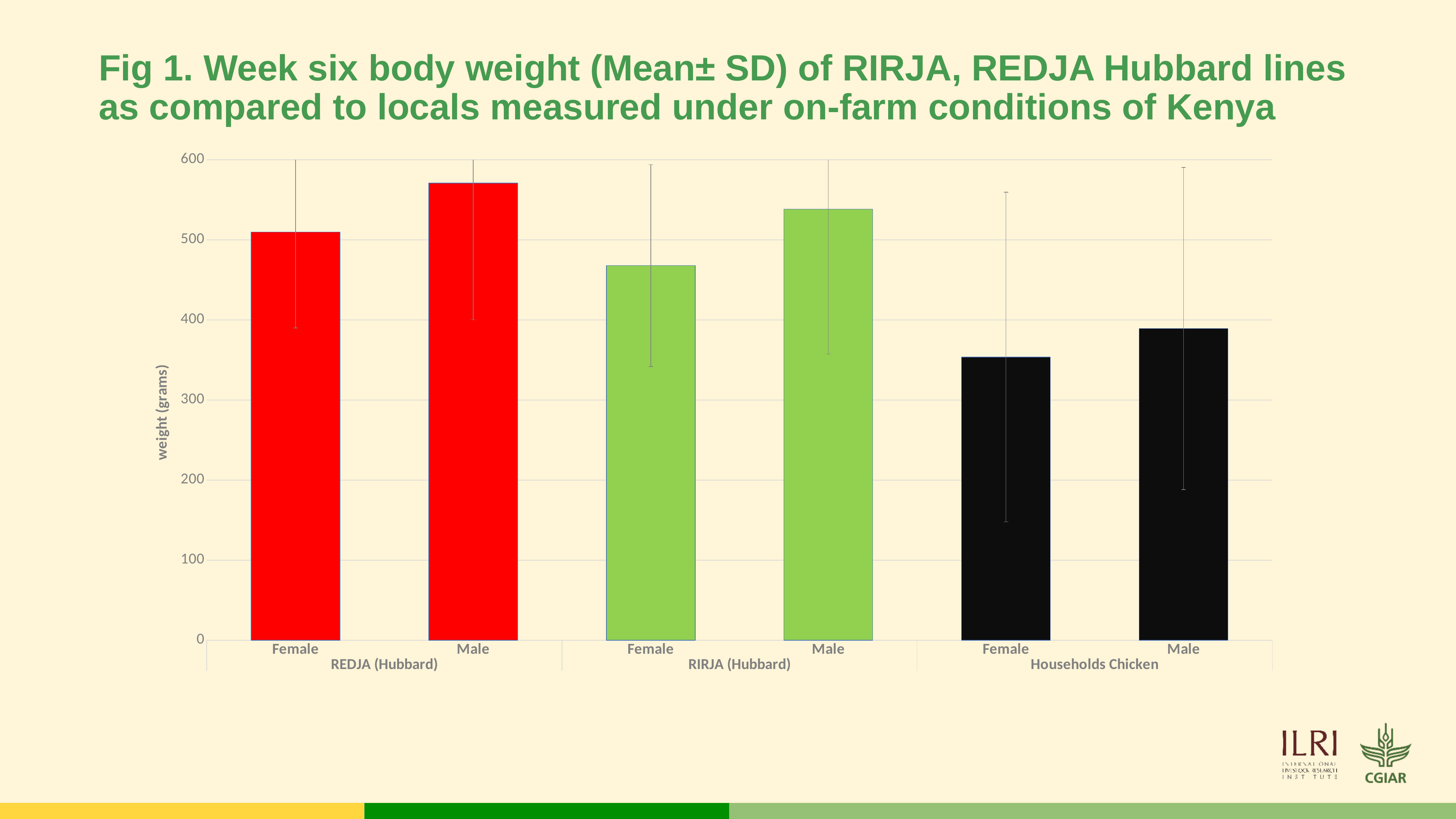
How many bars are plotted in the chart? 6 Which bar is the lowest in the chart? Households Chicken Female What kind of chart is shown on the slide? bar chart How many chicken groups are shown along the x axis? 3 Is the value for REDJA (Hubbard) Female greater or less than 500? greater Which bar is the highest in the chart? REDJA (Hubbard) Male Which is larger, the value for Households Chicken Female or Households Chicken Male? Households Chicken Male Is the value for Households Chicken Male greater or less than 400? less Is the value for RIRJA (Hubbard) Female greater or less than 500? less What is the label of the y axis? weight (grams) Which is larger, the value for REDJA (Hubbard) Male or RIRJA (Hubbard) Male? REDJA (Hubbard) Male